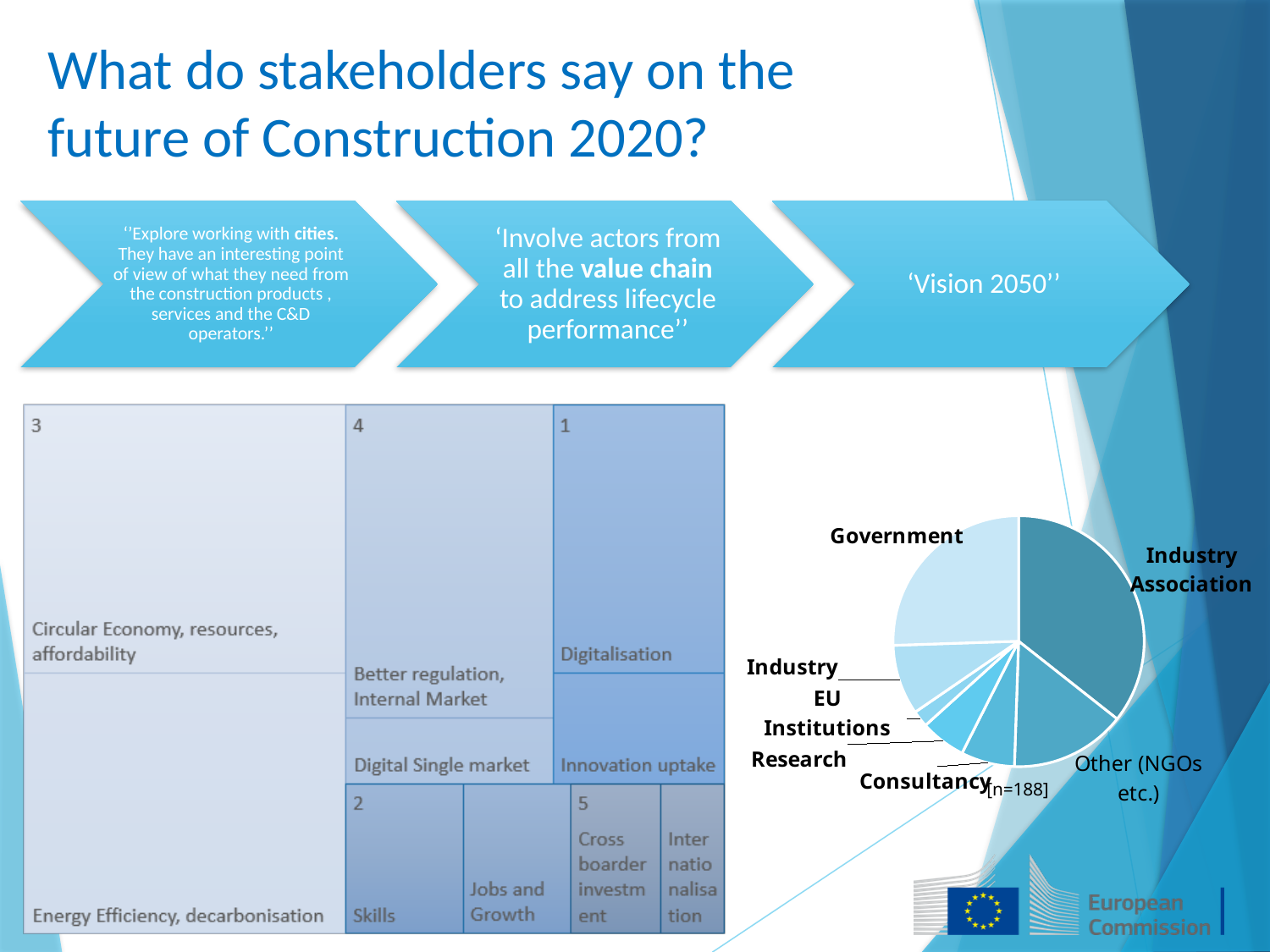
How many slices does the pie chart on the right have? 7 In the pie chart on the right, which slice is larger, Government or EU Institutions? Government In the treemap on the left, which topic is labelled with the number 2? Skills In the pie chart on the right, which slice is larger, Government or Consultancy? Government In the treemap on the left, which topic is labelled with the number 1? Digitalisation What kind of chart is the chart on the right of the slide? pie chart In the pie chart on the right, which slice is larger, Other (NGOs etc.) or Research? Other (NGOs etc.) In the treemap on the left, which topic is labelled with the number 3? Circular Economy, resources, affordability What sample size (n) is shown next to the pie chart on the right? n=188 In the pie chart on the right, which category has the largest slice? Industry Association